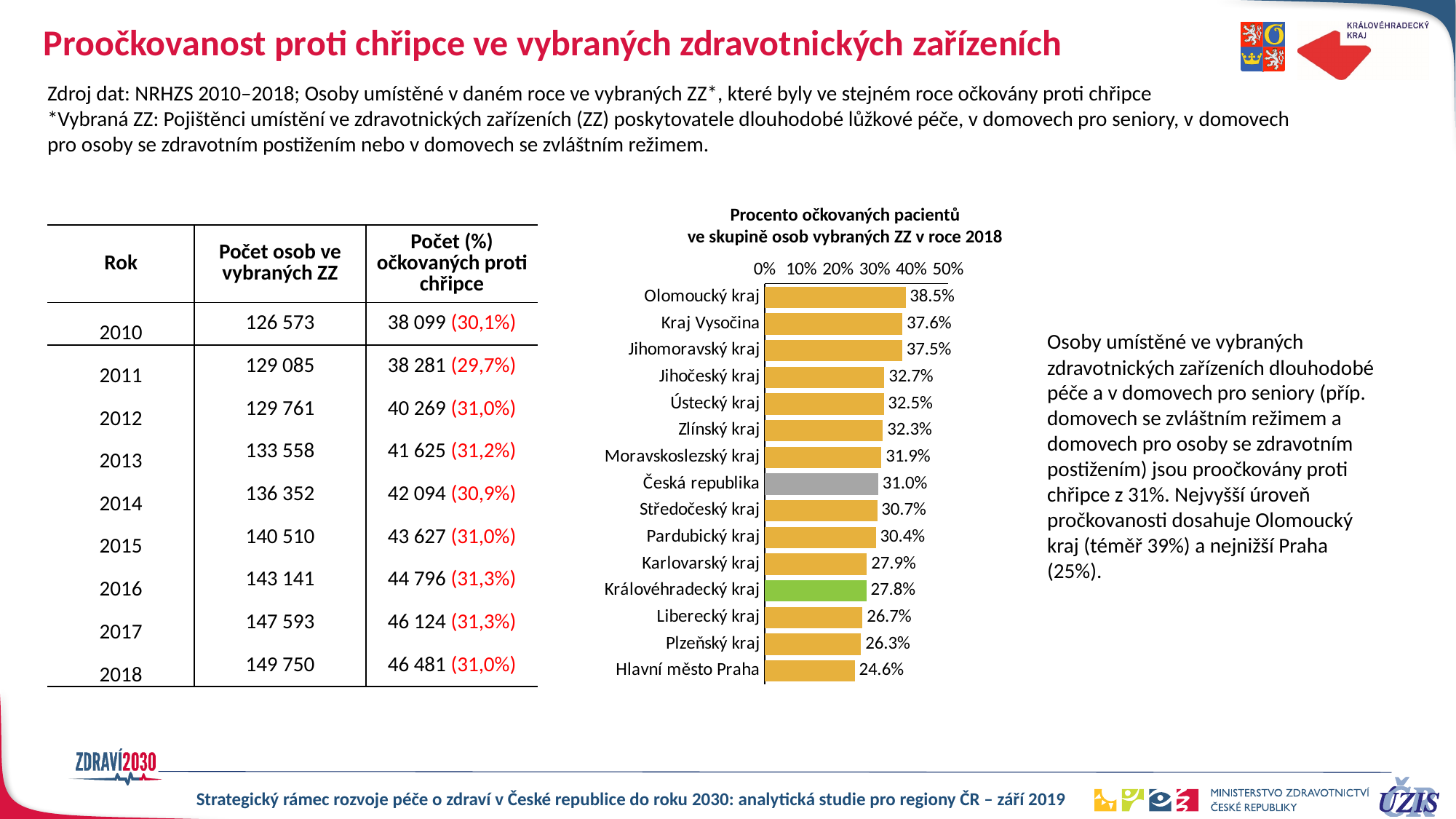
Which category has the lowest value in the chart? Hlavní město Praha Which category's bar is coloured green in the chart? Královéhradecký kraj What is the value for Královéhradecký kraj in the chart? 27.8% What is the value for Česká republika in the chart? 31.0% Is the value for Plzeňský kraj greater or less than 30%? less How many bars are shown in the chart? 15 Which has a larger value, Jihočeský kraj or Karlovarský kraj? Jihočeský kraj What is the difference between the values for Olomoucký kraj and Hlavní město Praha? 13.9 percentage points Which category has the highest value in the chart? Olomoucký kraj What is the value for Hlavní město Praha in the chart? 24.6% What is the value for Olomoucký kraj in the chart? 38.5% What kind of chart is shown on the slide? bar chart